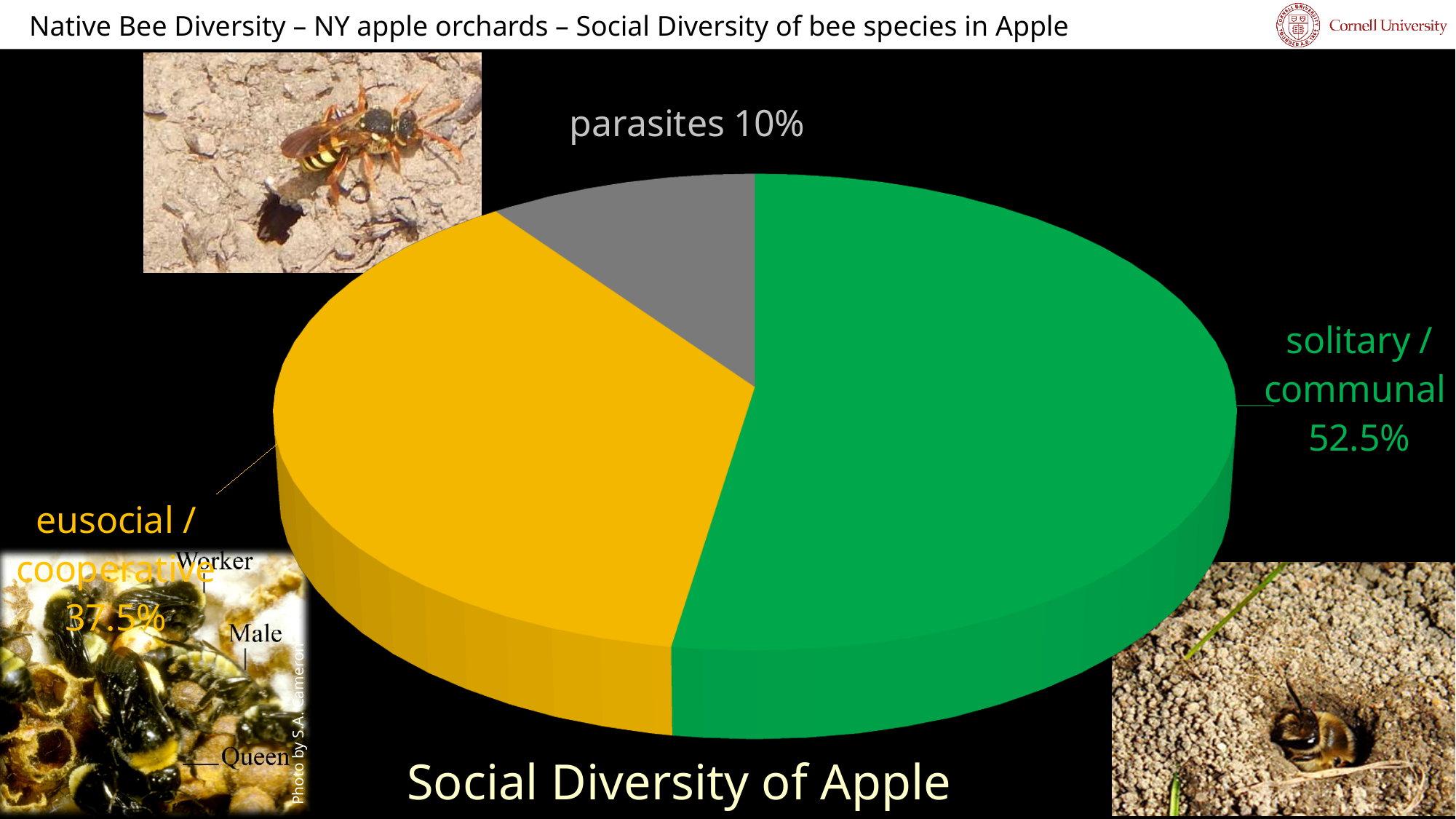
What share of the pie is labelled parasites? 10% What share of the pie is labelled solitary / communal? 52.5% What kind of chart is shown on the slide? pie chart Which is larger, the eusocial / cooperative slice or the parasites slice? eusocial / cooperative What is the title of the chart? Social Diversity of Apple Which category has the largest slice of the pie? solitary / communal What colour is the slice for parasites? grey How many slices does the pie chart have? 3 What is the combined share of the eusocial / cooperative and parasites slices? 47.5% Which category has the smallest slice of the pie? parasites What is the difference in percentage points between the solitary / communal slice and the eusocial / cooperative slice? 15 What share of the pie is labelled eusocial / cooperative? 37.5%